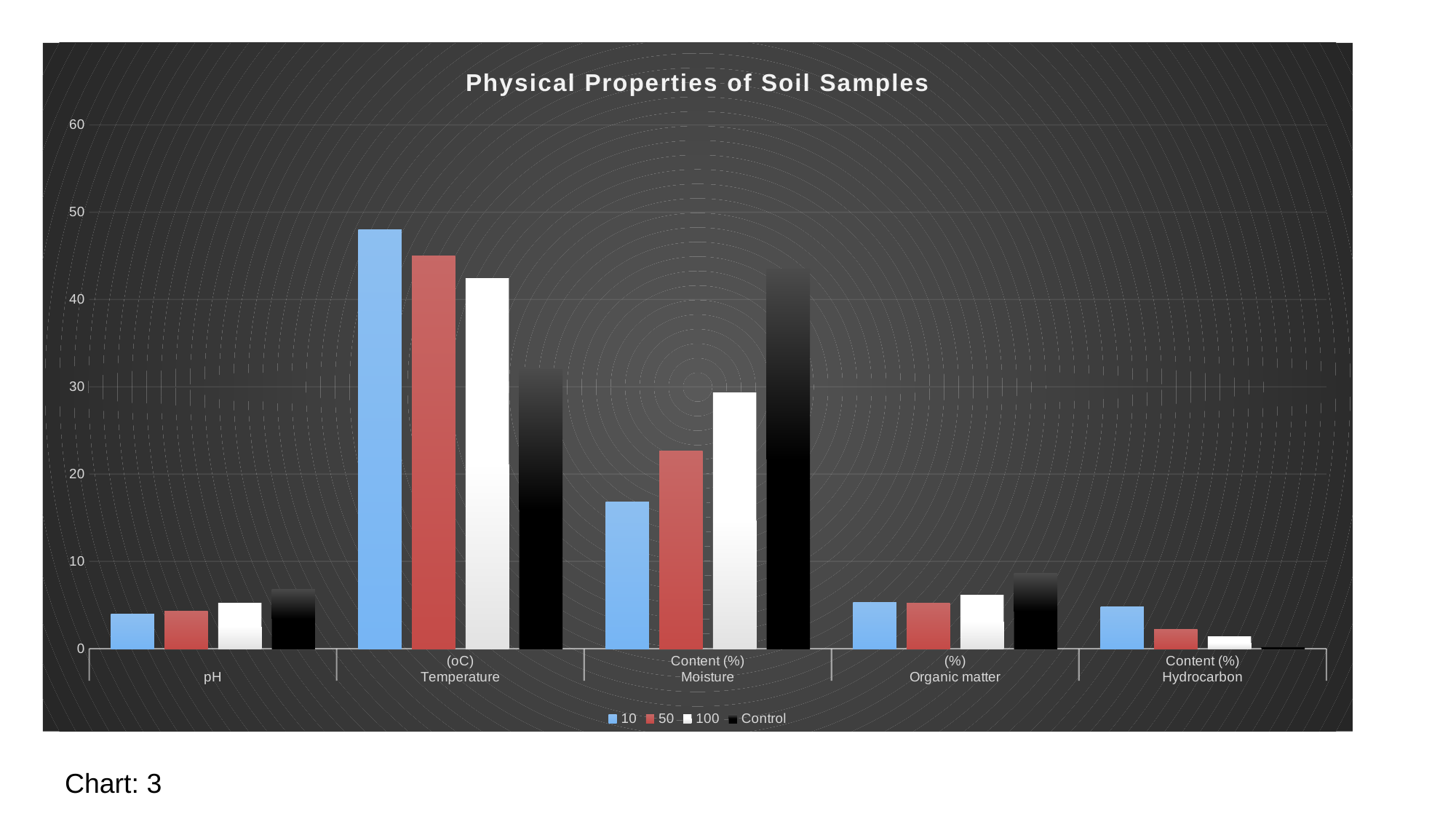
Which series has the lowest value in the Hydrocarbon Content (%) category? Control Is the value for the Control series in the Temperature (oC) category greater or less than 40? less Which series is drawn in black? Control How many series does the legend list? 4 Do the values for the Control series rise or fall from Moisture Content (%) to Hydrocarbon Content (%)? fall In the Temperature (oC) category, which series has the higher value, 10 or Control? 10 Is the value for the Control series in the Moisture Content (%) category greater or less than 40? greater Is the value for the 10 series in the Temperature (oC) category greater or less than 40? greater What is the title of the chart? Physical Properties of Soil Samples What kind of chart is shown on the slide? bar chart Which series has the highest value in the Moisture Content (%) category? Control How many categories are shown along the x axis? 5